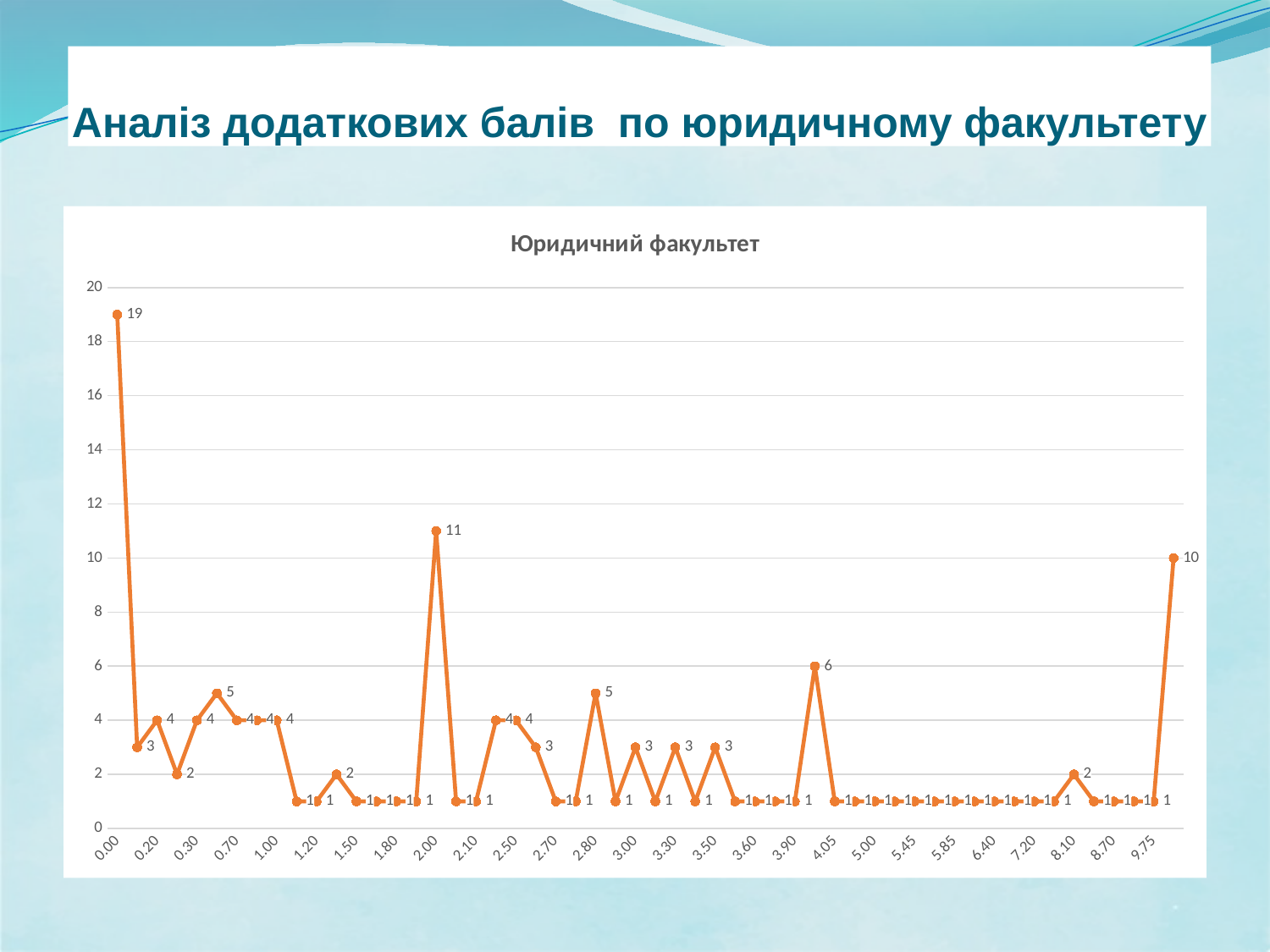
Which category has the highest value? 0.00 What is the value at the category 0.00? 19 What is the value at the category 2.80? 5 What is the value at the category 2.50? 4 Is the value at 0.00 greater or less than 18? greater What is the value at the category 2.00? 11 What type of chart is shown on the slide? line chart What is the difference between the values at 0.00 and 2.00? 8 What is the value at the category 8.10? 2 Which is larger, the value at 2.80 or the value at 3.00? 2.80 What is the difference between the values at 2.00 and 2.80? 6 What is the title of the chart? Юридичний факультет